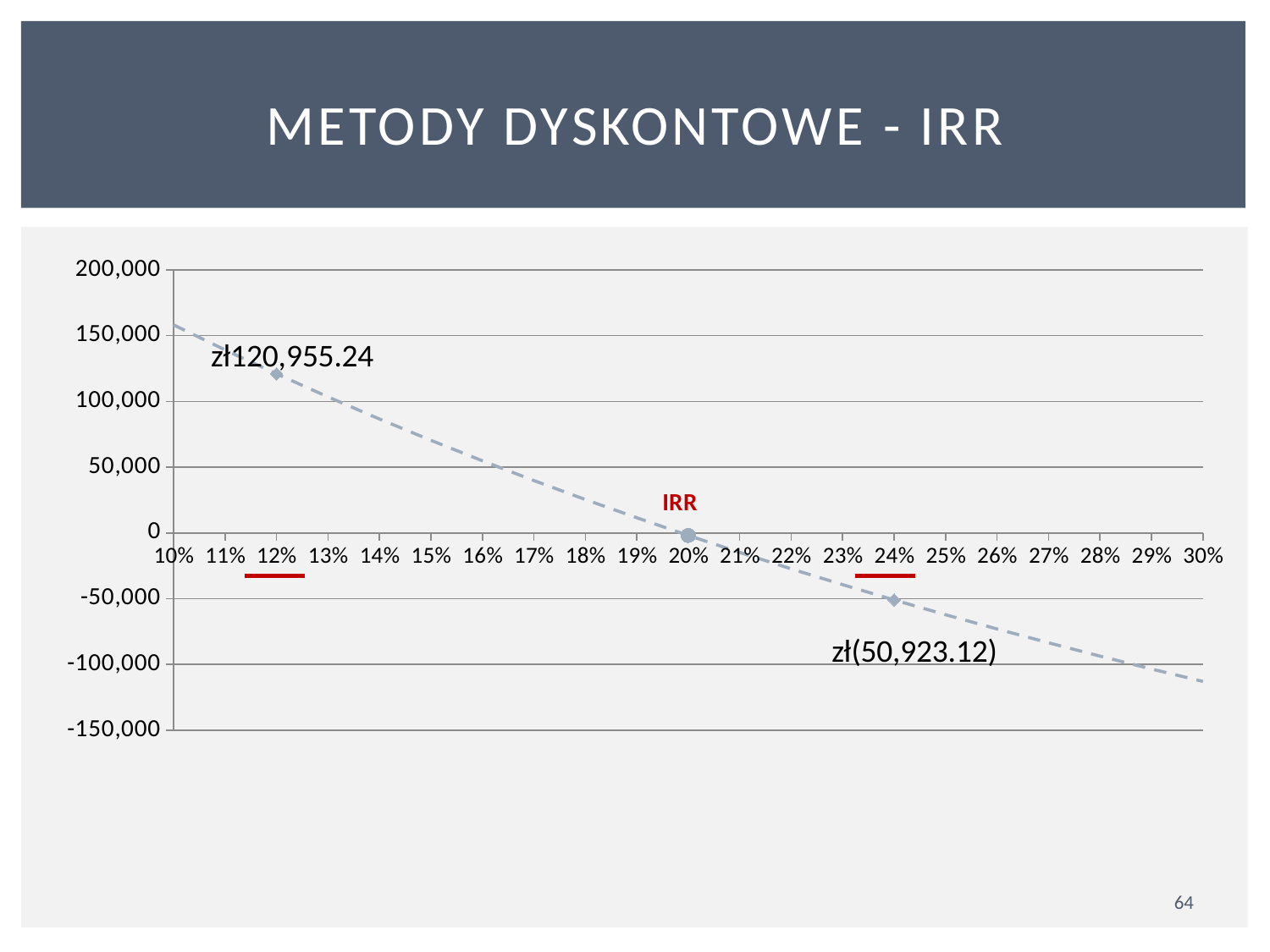
What is the value labelled at the 12% discount rate? zł120,955.24 At which discount rate on the x axis is the IRR point marked? 20% Is the value at 24% greater or less than 0? less Which of the two labelled points has the larger value, the one at 12% or the one at 24%? 12% What is the title of the chart's slide? METODY DYSKONTOWE - IRR What kind of chart is shown on the slide? line chart What is the difference between the value at 12% and the value at 24%? 171,878.36 What is the range of the x axis, from lowest to highest tick? 10% to 30% Is the value at 12% greater or less than 100,000? greater What is the value labelled at the 24% discount rate? zł(50,923.12) Do the values rise or fall as the discount rate increases along the x axis? fall How many data points on the chart have printed value labels? 2